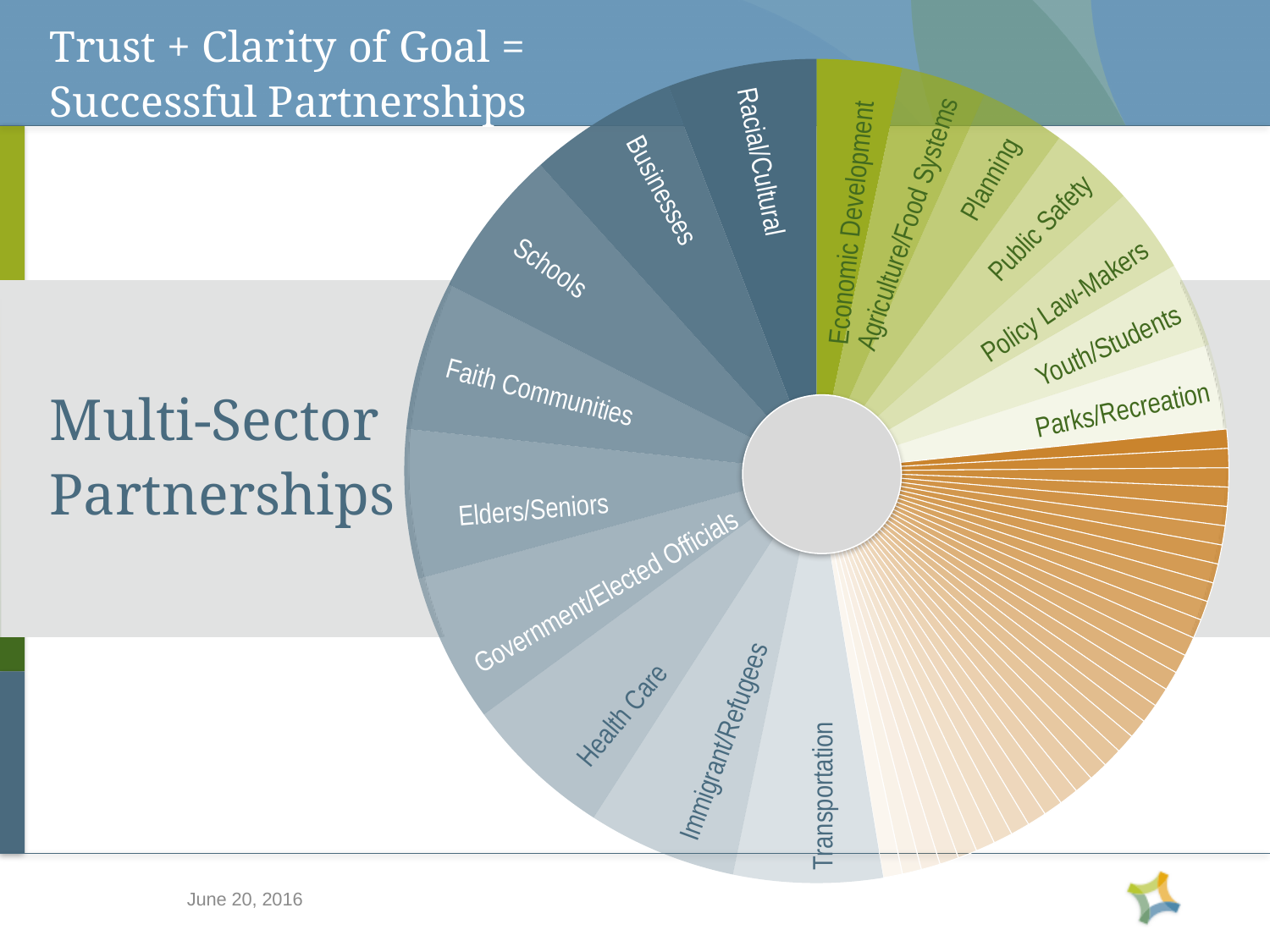
Which slice is larger, Faith Communities or Economic Development? Faith Communities Which slice is larger, Schools or Agriculture/Food Systems? Schools What heading appears to the left of the pie chart? Multi-Sector Partnerships How many labeled categories does the pie chart show? 16 Which slice is larger, Elders/Seniors or Planning? Elders/Seniors What kind of chart is shown on the slide? pie chart What colour is the Economic Development slice? green